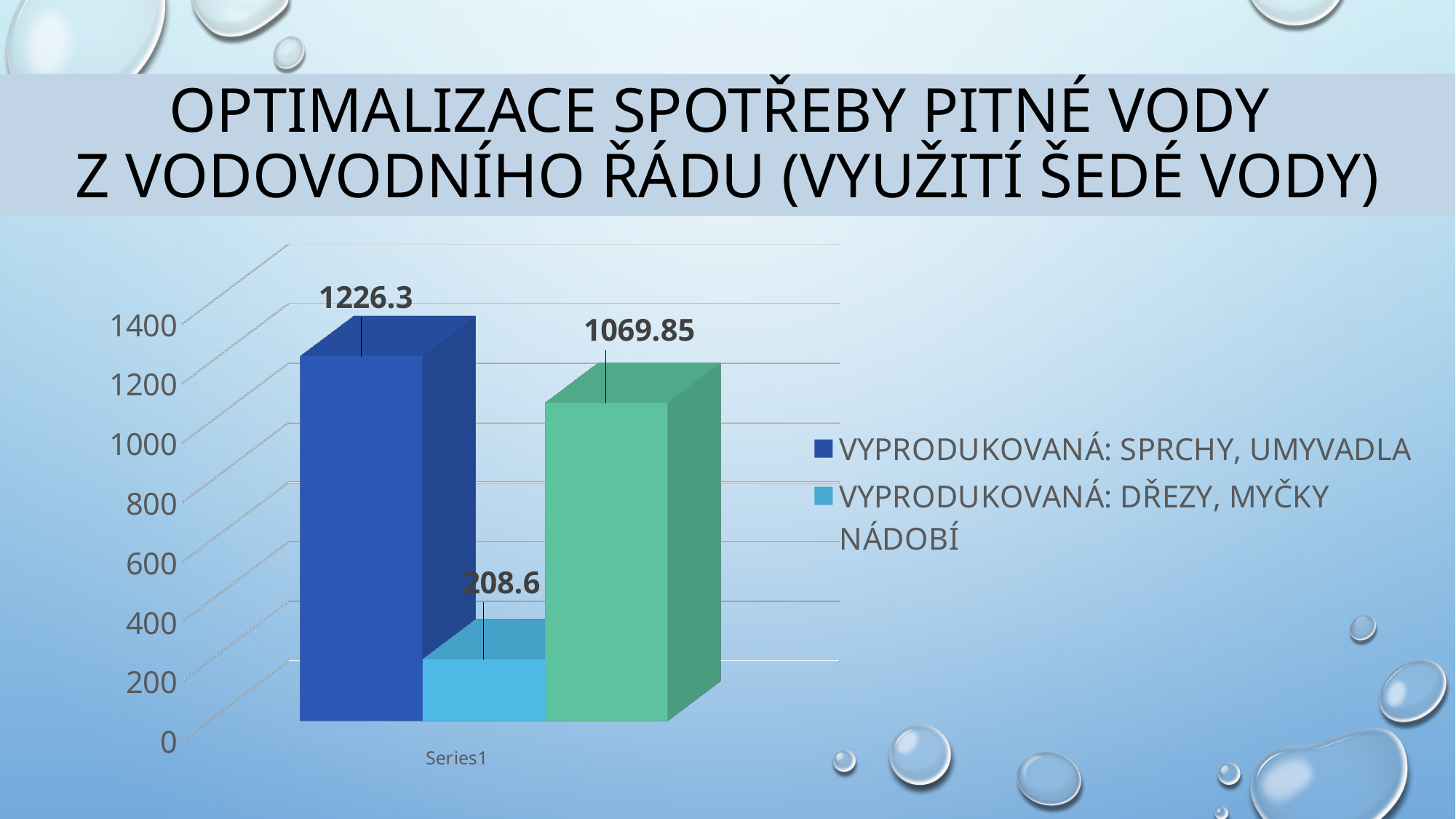
Is the value for "Vyprodukovaná: dřezy, myčky nádobí" greater or less than 400? less How many series does the legend list? 2 Which is larger: the value for "Vyprodukovaná: sprchy, umyvadla" or the value of the green bar? Vyprodukovaná: sprchy, umyvadla What is the value for "Vyprodukovaná: dřezy, myčky nádobí"? 208.6 Which legend series has the lowest value? Vyprodukovaná: dřezy, myčky nádobí What is the difference between the value for "Vyprodukovaná: sprchy, umyvadla" and the value for "Vyprodukovaná: dřezy, myčky nádobí"? 1017.7 What is the value for "Vyprodukovaná: sprchy, umyvadla"? 1226.3 What value is labelled on the green bar? 1069.85 Which legend series has the highest value? Vyprodukovaná: sprchy, umyvadla What is the difference between the dark blue bar (1226.3) and the green bar (1069.85)? 156.45 How many bars are plotted in the chart? 3 What kind of chart is shown on the slide? bar chart